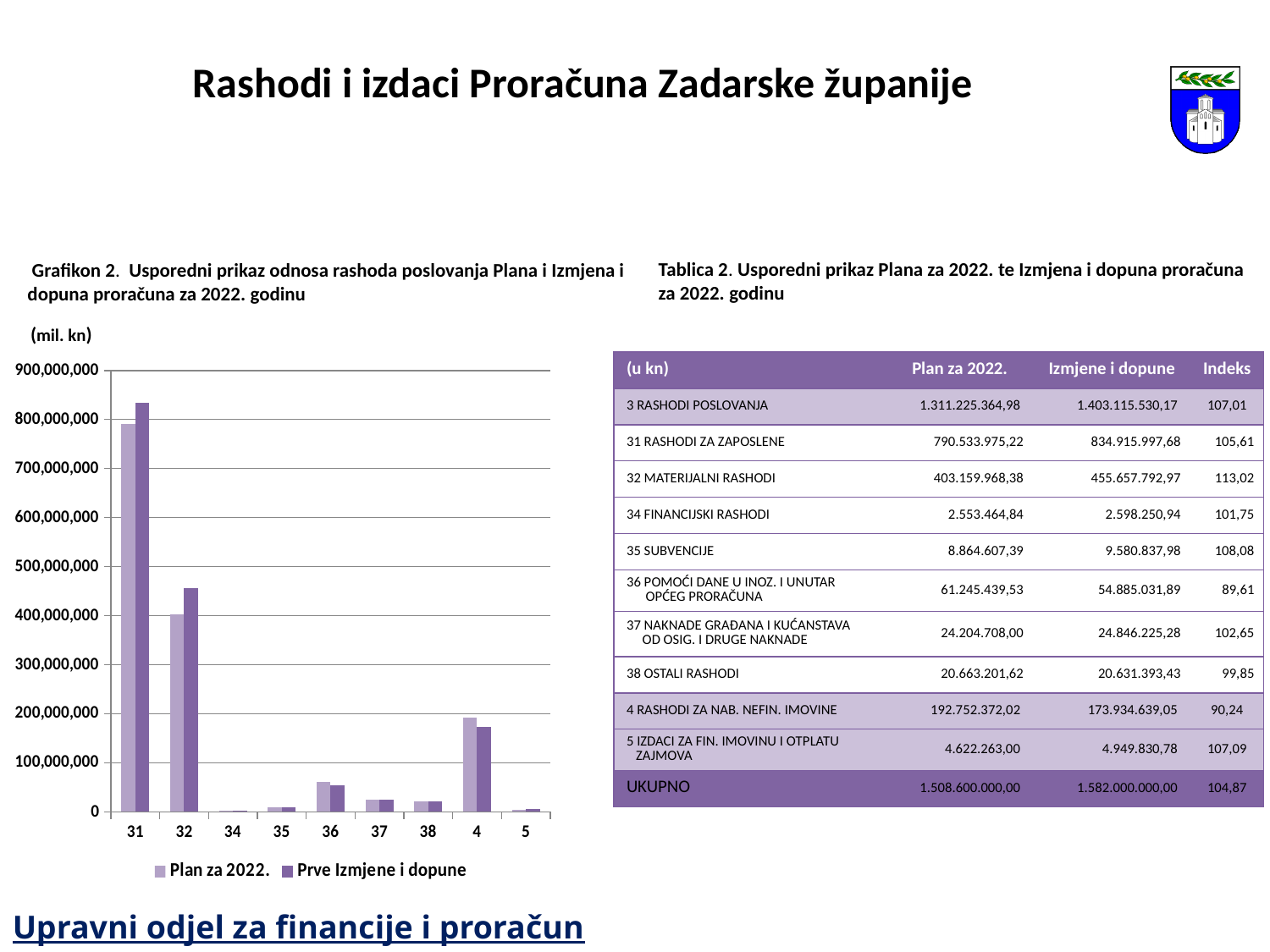
Is the Plan za 2022. value for category 31 greater or less than 700,000,000? greater How many categories are shown on the x axis of the chart? 9 For category 32, which series has the larger value: Plan za 2022. or Prve Izmjene i dopune? Prve Izmjene i dopune Which category has the highest value for the Prve Izmjene i dopune series? 31 What kind of chart is shown on the slide? bar chart What are the two series names listed in the chart's legend? Plan za 2022. and Prve Izmjene i dopune Which category has the highest value for the Plan za 2022. series? 31 For category 4, which series has the larger value: Plan za 2022. or Prve Izmjene i dopune? Plan za 2022. Is the Prve Izmjene i dopune value for category 31 greater or less than 800,000,000? greater How many series does the chart's legend list? 2 Is the Plan za 2022. value for category 36 greater or less than 100,000,000? less